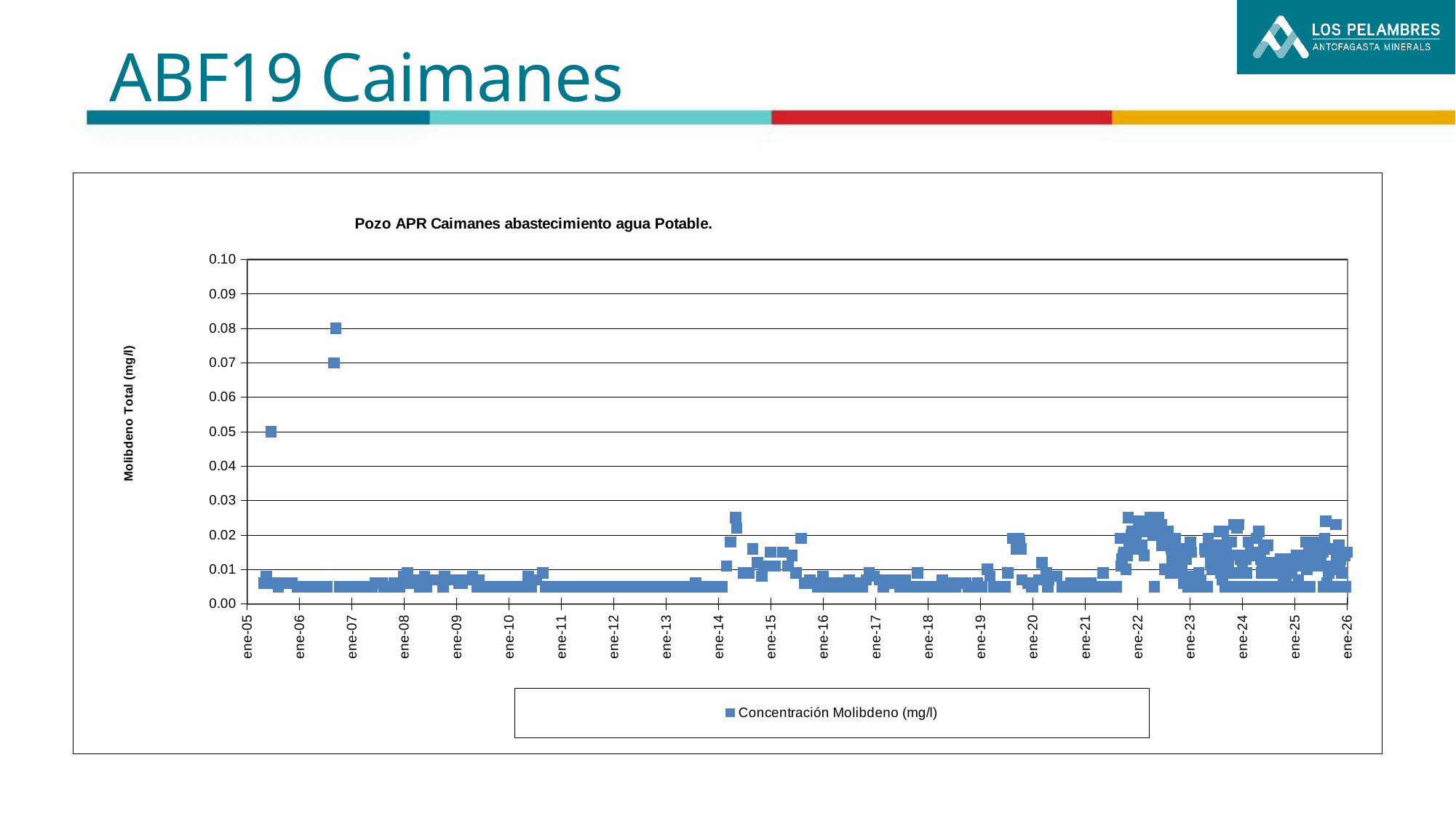
What is the title of the chart? Pozo APR Caimanes abastecimiento agua Potable. What is the highest molybdenum concentration value plotted on the chart? 0.08 Which is larger: the value of the highest point near ene-07 or the values plotted around ene-13? the point near ene-07 Are the values plotted between ene-09 and ene-13 greater or less than 0.02? less What is the label of the vertical axis? Molibdeno Total (mg/l) How many series does the legend list? 1 How many year labels are shown on the horizontal axis? 22 Is the highest plotted value greater or less than 0.05? greater Is the isolated point plotted in 2005 greater or less than 0.04? greater What kind of chart is shown on the slide? scatter chart What is the legend entry for the plotted series? Concentración Molibdeno (mg/l) Do the values fall or rise from the peak near ene-07 to ene-08? fall